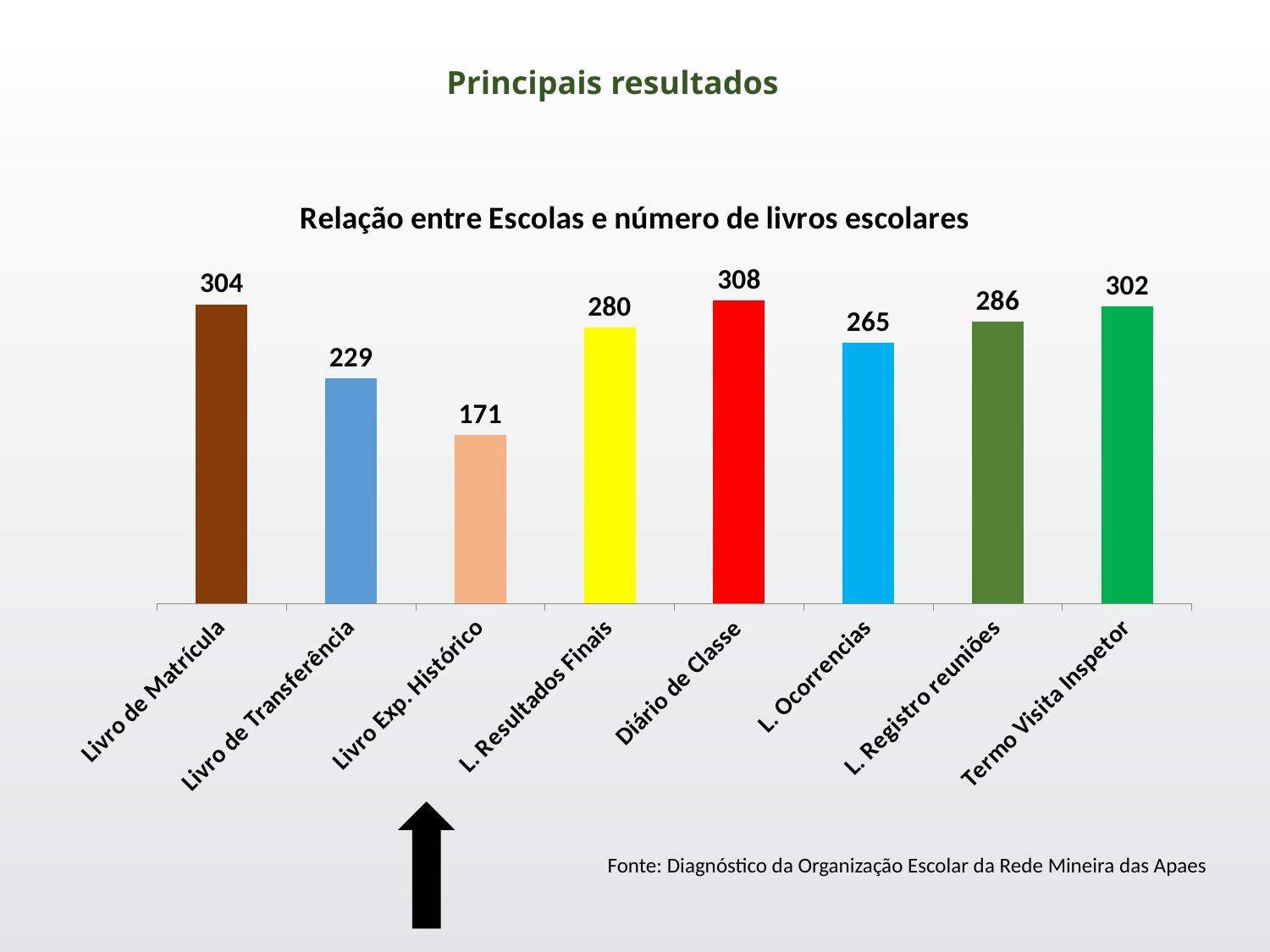
What kind of chart is shown on the slide? Bar chart What is the difference between the values for Diário de Classe and Livro Exp. Histórico? 137 What is the value for Livro Exp. Histórico? 171 Which category has the highest value? Diário de Classe What is the title of the chart? Relação entre Escolas e número de livros escolares What is the value for Livro de Matrícula? 304 What is the value for L. Ocorrencias? 265 Which category has the lowest value? Livro Exp. Histórico Which is larger, the value for L. Resultados Finais or the value for L. Ocorrencias? L. Resultados Finais What is the value for Termo Visita Inspetor? 302 How many categories are shown in the chart? 8 What is the difference between the values for L. Registro reuniões and Livro de Transferência? 57